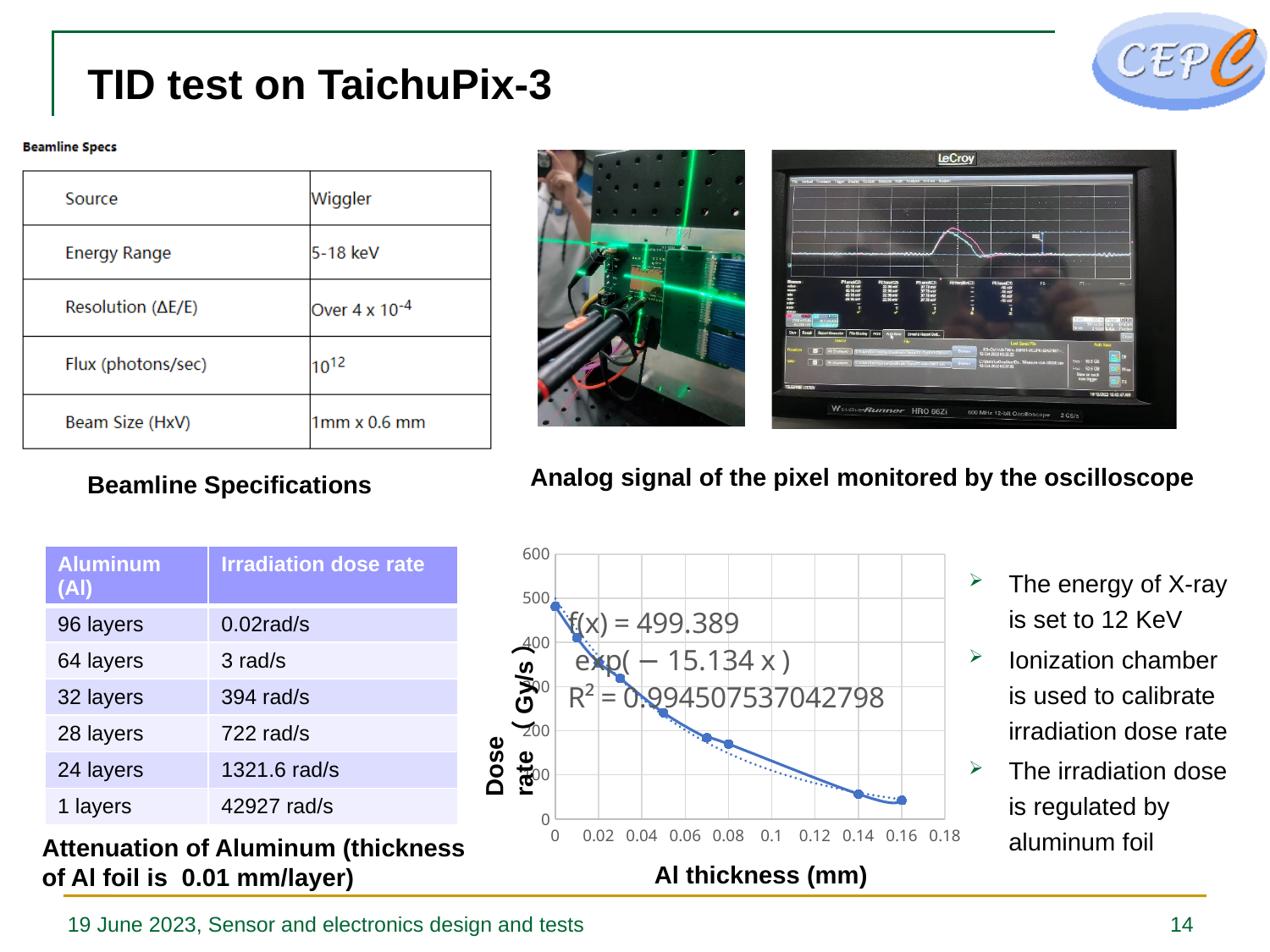
Is the dose rate at Al thickness 0 mm greater or less than 400 Gy/s? greater What is the x-axis title of the chart? Al thickness (mm) What is the fitted trendline equation shown on the chart? f(x) = 499.389 exp(−15.134 x) Is the dose rate at Al thickness 0.05 mm greater or less than 200 Gy/s? greater Is the dose rate at Al thickness 0.16 mm greater or less than 100 Gy/s? less What is the y-axis title of the chart? Dose rate (Gy/s) What R² value is shown on the chart? 0.994507537042798 Does the dose rate rise or fall as Al thickness increases? Fall What is the highest value shown on the y-axis of the chart? 600 Which has the larger dose rate: Al thickness 0 mm or 0.16 mm? 0 mm What kind of chart is shown on the slide? Scatter chart with a fitted line